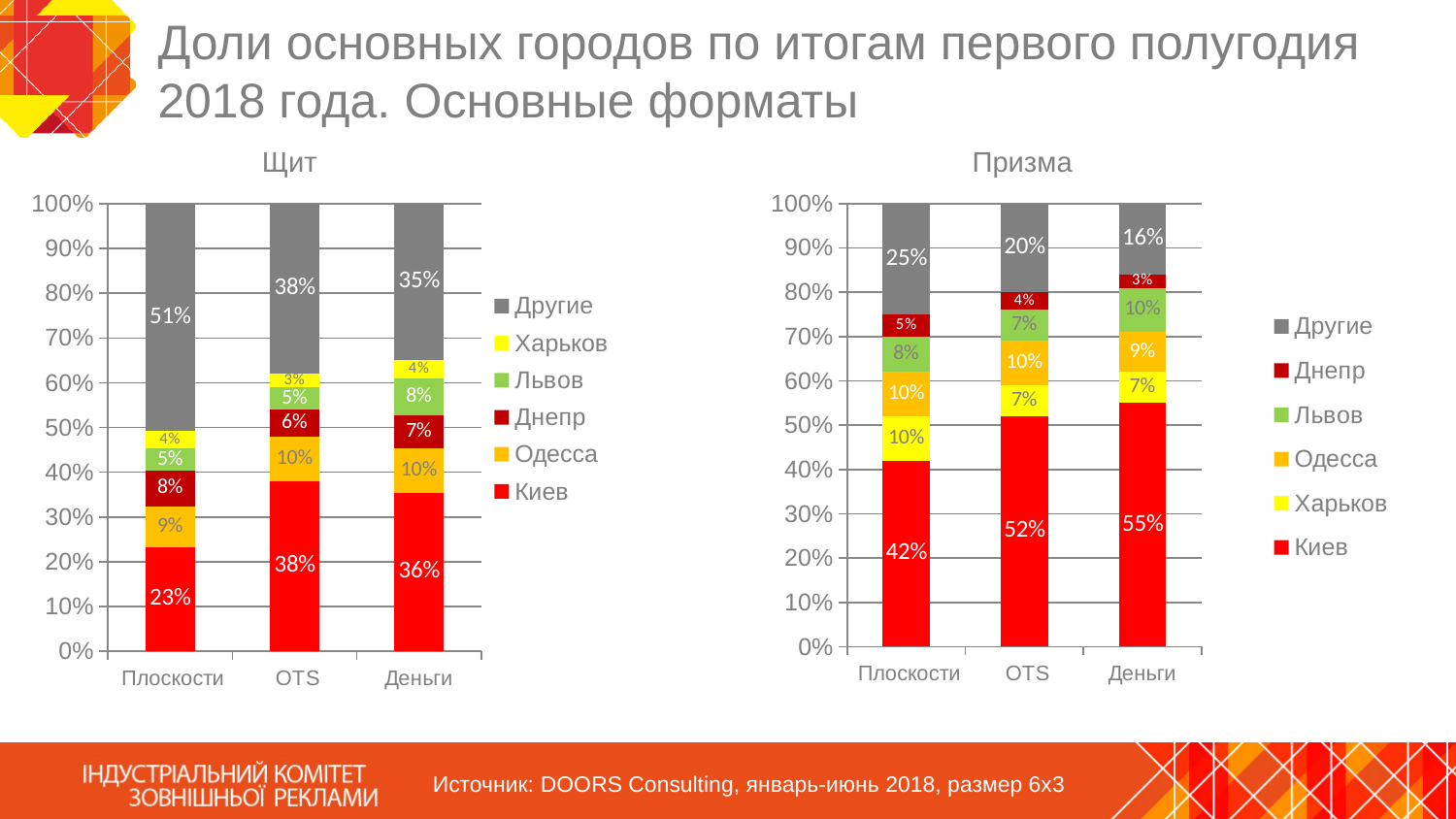
In the "Призма" chart, what is the combined value of Киев and Другие in the Плоскости bar? 67% In the "Призма" chart, what is the value for Киев in the Деньги bar? 55% In the "Призма" chart, what is the difference between the Киев values for Деньги and Плоскости? 13% How many series does the legend of the "Призма" chart list? 6 How many categories are shown on the x axis of the "Щит" chart? 3 In the "Призма" chart, what is the value for Другие in the OTS bar? 20% What kind of chart is the "Призма" chart? Stacked bar chart In the "Призма" chart, which category has the highest value for Киев? Деньги In the "Щит" chart, which is larger: Другие for Плоскости or Другие for OTS? Другие for Плоскости In the "Щит" chart, which category has the lowest value for Киев? Плоскости In the "Щит" chart, what is the value for Другие in the Плоскости bar? 51% In the "Щит" chart, what is the value for Киев in the Плоскости bar? 23%